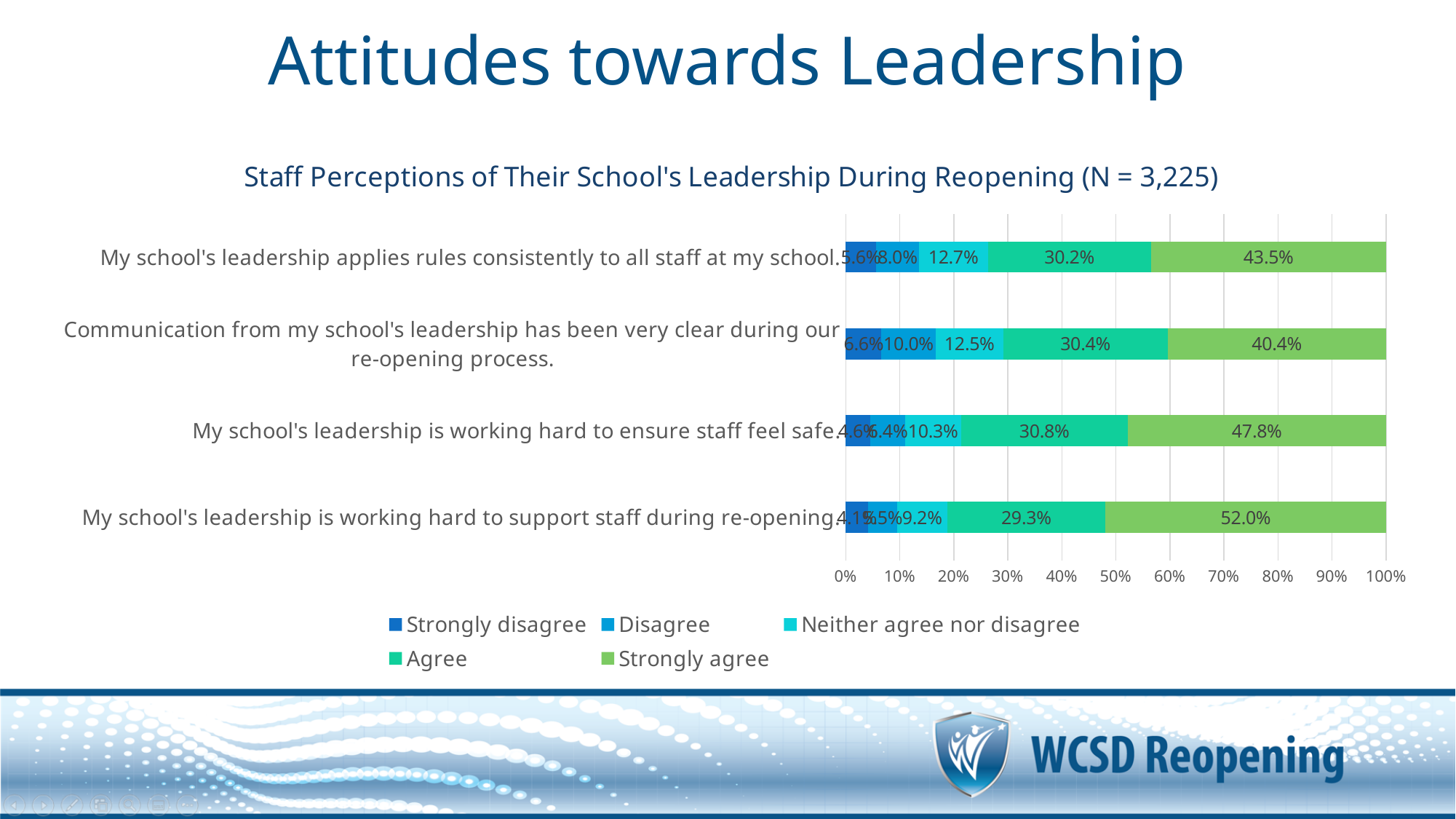
What percentage of staff strongly agree that their school's leadership is working hard to support staff during re-opening? 52.0% Which statement has the highest Strongly agree percentage? My school's leadership is working hard to support staff during re-opening. What is the 'Neither agree nor disagree' value for 'My school's leadership is working hard to ensure staff feel safe'? 10.3% What is the Agree value for the statement 'My school's leadership applies rules consistently to all staff at my school'? 30.2% What is the difference in Strongly agree percentage between the 'support staff during re-opening' statement and the 'communication has been very clear' statement? 11.6% Which has a larger Strongly agree share: 'working hard to ensure staff feel safe' or 'applies rules consistently to all staff'? My school's leadership is working hard to ensure staff feel safe. What is the Disagree value for the statement about communication from school leadership being very clear? 10.0% How many series does the legend list? 5 What kind of chart is shown on the slide? Bar chart How many statements (categories) are plotted in the chart? 4 Which statement has the lowest Strongly agree percentage? Communication from my school's leadership has been very clear during our re-opening process. What sample size (N) is given in the chart title? 3,225